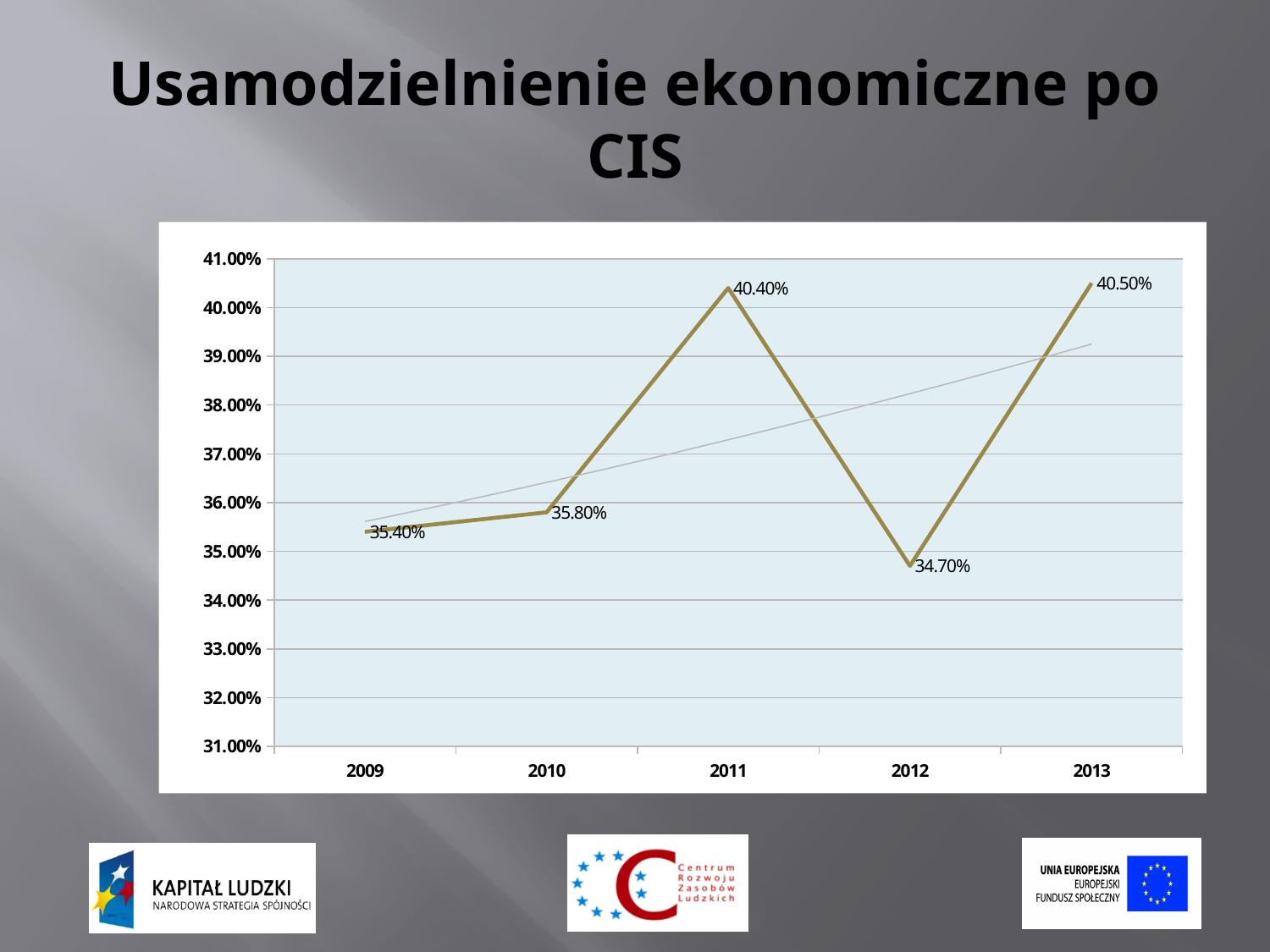
What is the difference between the values for 2011 and 2012? 5.70% Which year has the highest value? 2013 What is the value for 2011? 40.40% Which year has the lowest value? 2012 What is the value for 2013? 40.50% Which is larger, the value for 2010 or the value for 2012? 2010 What is the value for 2009? 35.40% What is the value for 2012? 34.70% What is the difference between the values for 2010 and 2009? 0.40% How many years are plotted on the chart? 5 What kind of chart is shown on the slide? line chart Does the value rise or fall from 2011 to 2012? fall